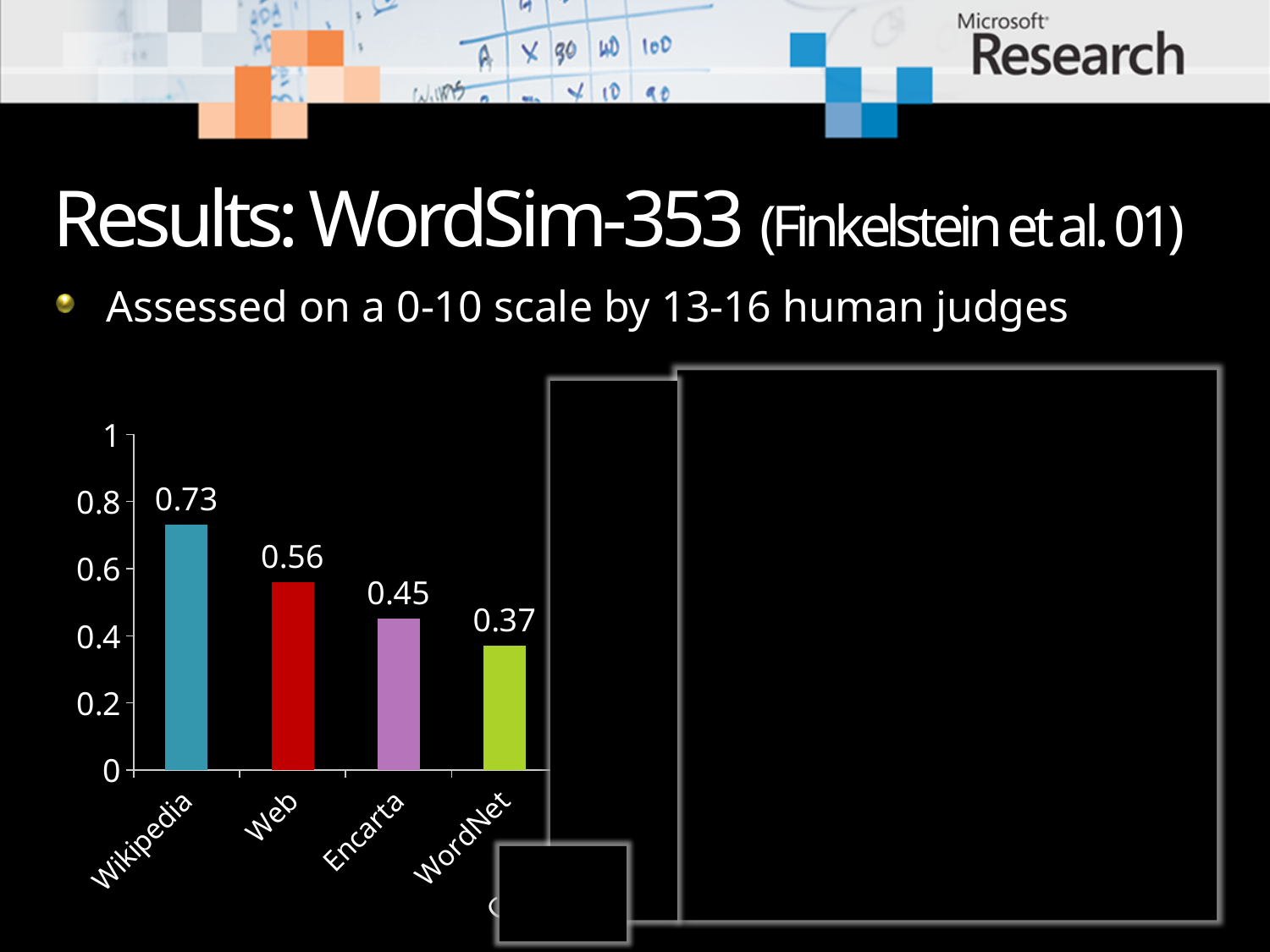
What is the difference between the values for Wikipedia and WordNet? 0.36 What is the value for Encarta? 0.45 Which is larger, the value for Web or the value for Encarta? Web Which category has the highest value? Wikipedia Is the value for Wikipedia greater or less than 0.6? greater Which category has the lowest value? WordNet What is the difference between the values for Web and Encarta? 0.11 What is the value for Web? 0.56 What is the value for WordNet? 0.37 What is the value for Wikipedia? 0.73 What kind of chart is shown? bar chart How many categories are shown on the x axis? 4